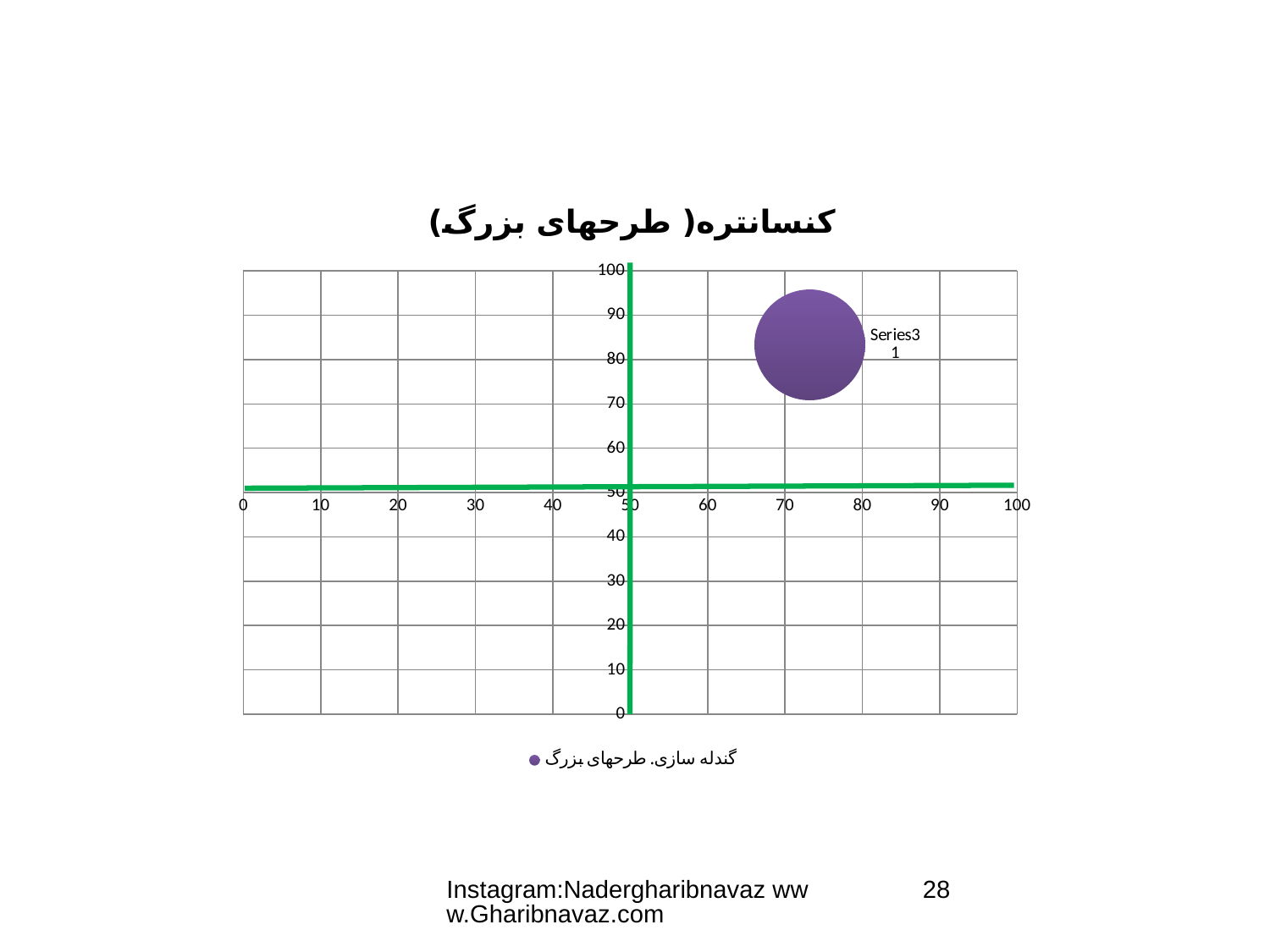
How many bubbles are plotted on the chart? 1 What is the title of the chart? کنسانتره( طرحهای بزرگ) What kind of chart is shown on the slide? bubble chart How many series does the chart legend list? 1 Is the horizontal (x-axis) position of the plotted bubble greater or less than 90? less What is the legend entry shown below the chart? گندله سازی. طرحهای بزرگ Is the vertical (y-axis) position of the plotted bubble greater or less than 90? less Is the horizontal (x-axis) position of the plotted bubble greater or less than 50? greater What is the maximum value shown on the y-axis? 100 At what value do the two green reference lines cross on the x-axis? 50